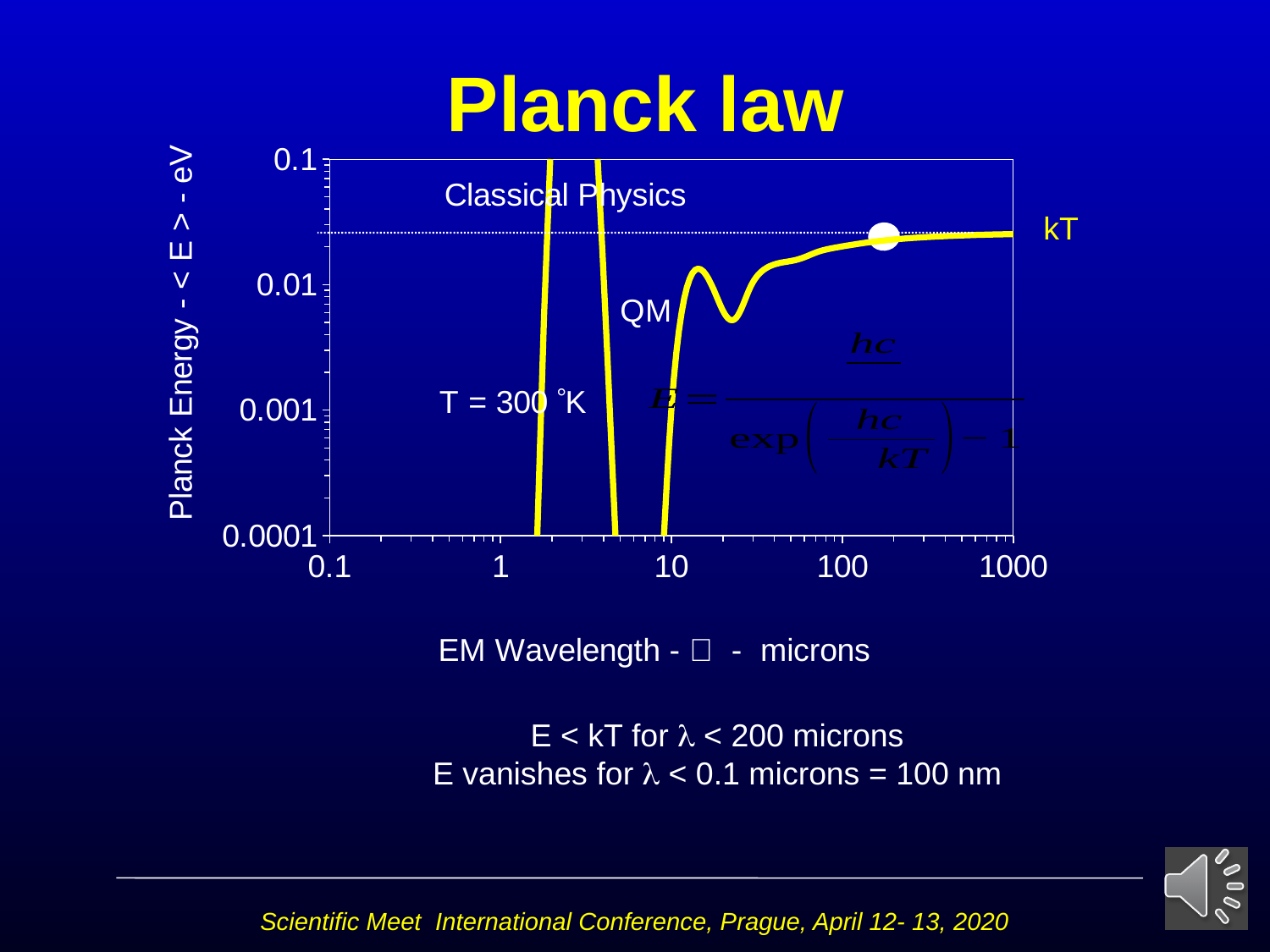
What temperature is stated on the chart? T = 300 °K Does the curve rise or fall as wavelength increases from 100 to 1000 microns? rise Is the Planck energy at 100 microns greater or less than 0.01? greater What is the title of the chart? Planck law What is the lowest value labelled on the y axis? 0.0001 Is the Planck energy at 1000 microns greater or less than 0.01? greater What is the highest value labelled on the x axis? 1000 What kind of chart is shown on the slide? line chart What is the label of the x axis? EM Wavelength - λ - microns Which is larger, the Planck energy at 10 microns or at 1000 microns? 1000 microns Is the Planck energy at 1000 microns greater or less than 0.1? less How many tick labels are printed on the x axis? 5